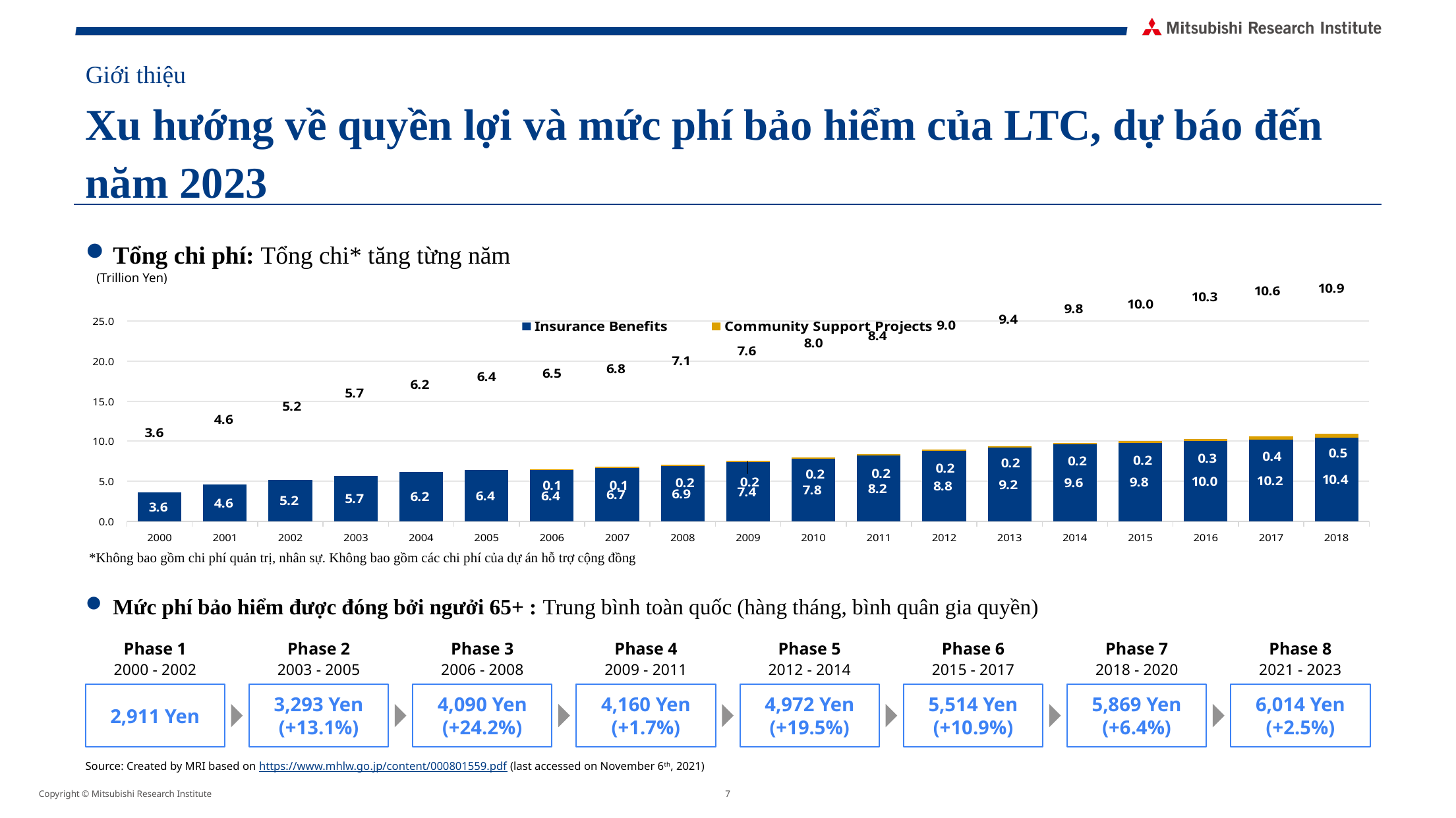
What is the Community Support Projects value for 2018? 0.5 Which is larger, the Insurance Benefits value for 2005 or for 2009? 2009 Which year has the lowest Insurance Benefits value? 2000 What is the difference between the Insurance Benefits values for 2018 and 2000? 6.8 How many years are shown on the x axis? 19 What is the Insurance Benefits value for 2010? 7.8 Do the total values rise or fall from 2000 to 2018? Rise Which year has the highest total spending? 2018 What is the total labelled above the bar for 2012? 9.0 Is the total for 2016 greater or less than 15.0? less How many series does the legend list? 2 What kind of chart is shown? Stacked bar chart